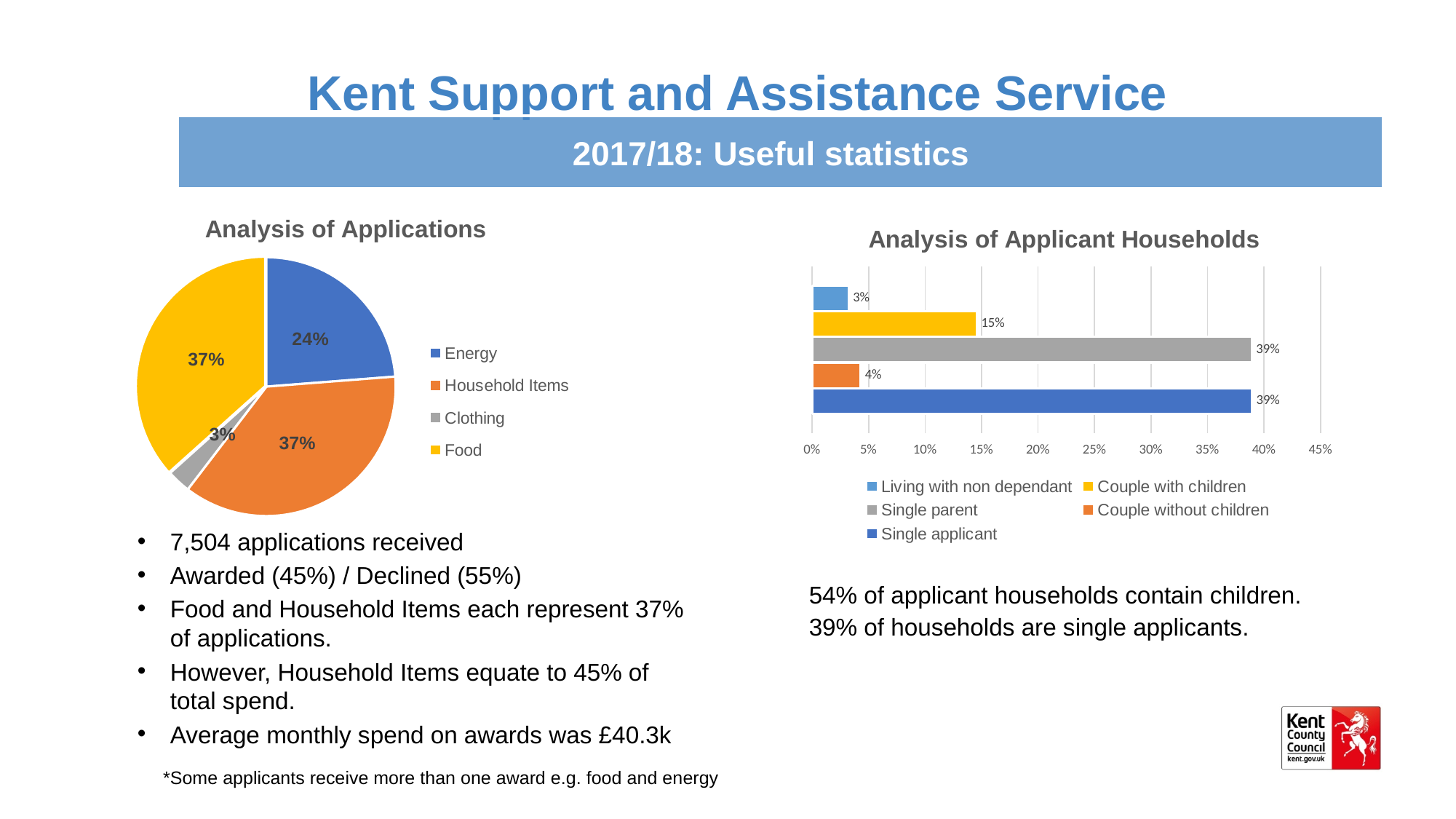
In the Analysis of Applicant Households chart, what is the difference between Single applicant and Couple with children? 24% In the Analysis of Applications chart, what share of applications is Clothing? 3% In the Analysis of Applicant Households chart, which category has the lowest value? Living with non dependant In the Analysis of Applications chart, what is the difference between the Energy share and the Clothing share? 21% In the Analysis of Applicant Households chart, which is larger: Single parent or Couple with children? Single parent In the Analysis of Applications chart, which category has the smallest share? Clothing In the Analysis of Applicant Households chart, what type of chart is used? Bar chart In the Analysis of Applications chart, what type of chart is used? Pie chart In the Analysis of Applications chart, what share of applications is Energy? 24% In the Analysis of Applicant Households chart, what is the value for Couple with children? 15% In the Analysis of Applications chart, how many categories does the legend list? 4 In the Analysis of Applicant Households chart, what is the value for Couple without children? 4%